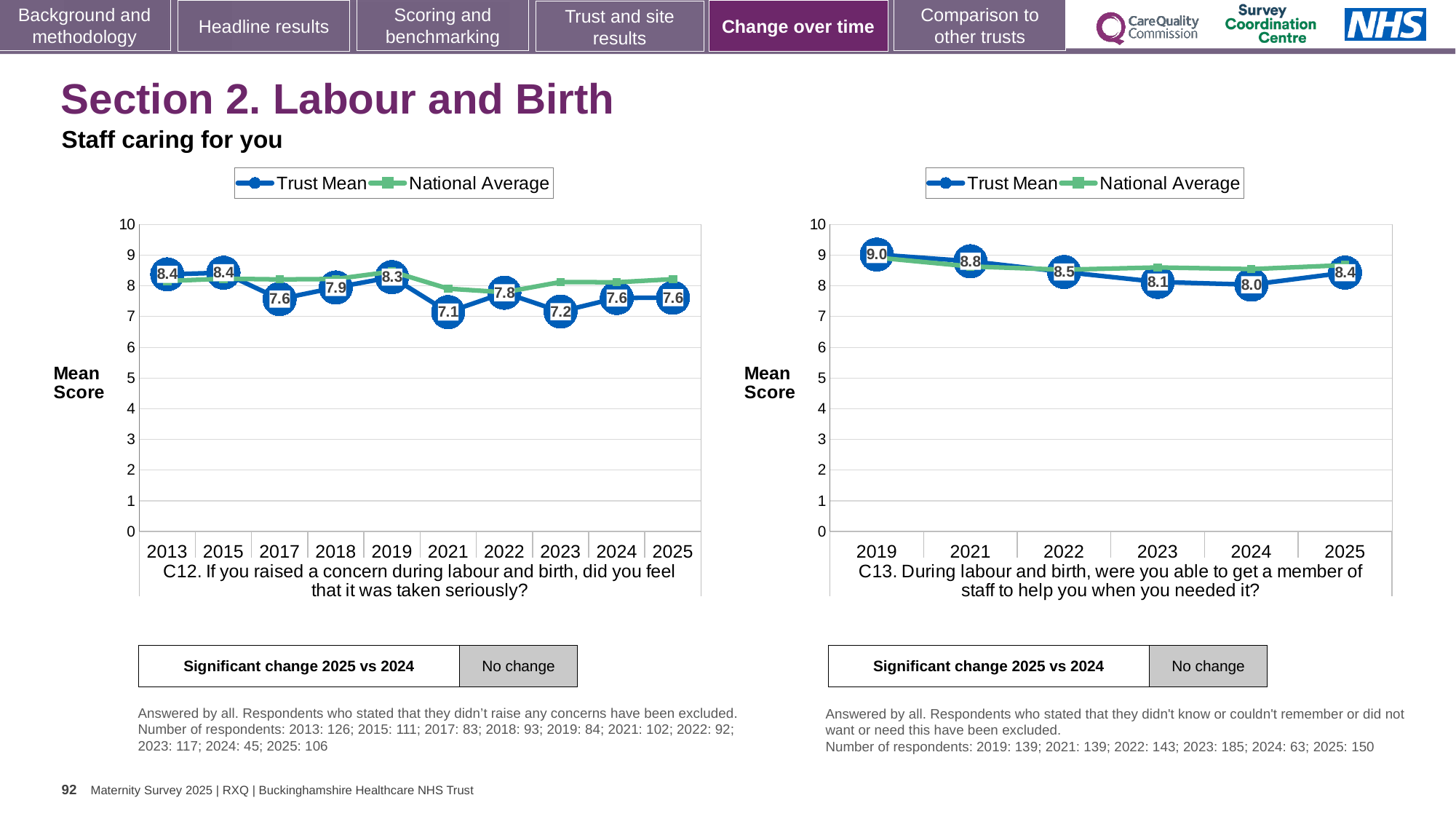
In the C12 chart (left), is the National Average value for 2021 greater or less than 7? greater What does the y axis of the C12 chart (left) represent? Mean Score In the C12 chart (left), what is the Trust Mean score for 2021? 7.1 In the C13 chart (right), what is the Trust Mean score for 2023? 8.1 In the C13 chart (right), which year has the highest Trust Mean score? 2019 In the C12 chart (left), which year has the lowest Trust Mean score? 2021 What type of chart is the C13 chart (right)? Line chart In the C13 chart (right), what is the difference between the Trust Mean scores for 2019 and 2024? 1.0 How many series does the legend of the C13 chart (right) list? 2 In the C12 chart (left), is the Trust Mean score higher in 2019 or in 2023? 2019 How many years are plotted on the x axis of the C12 chart (left)? 10 In the C13 chart (right), does the Trust Mean rise or fall from 2019 to 2024? Fall